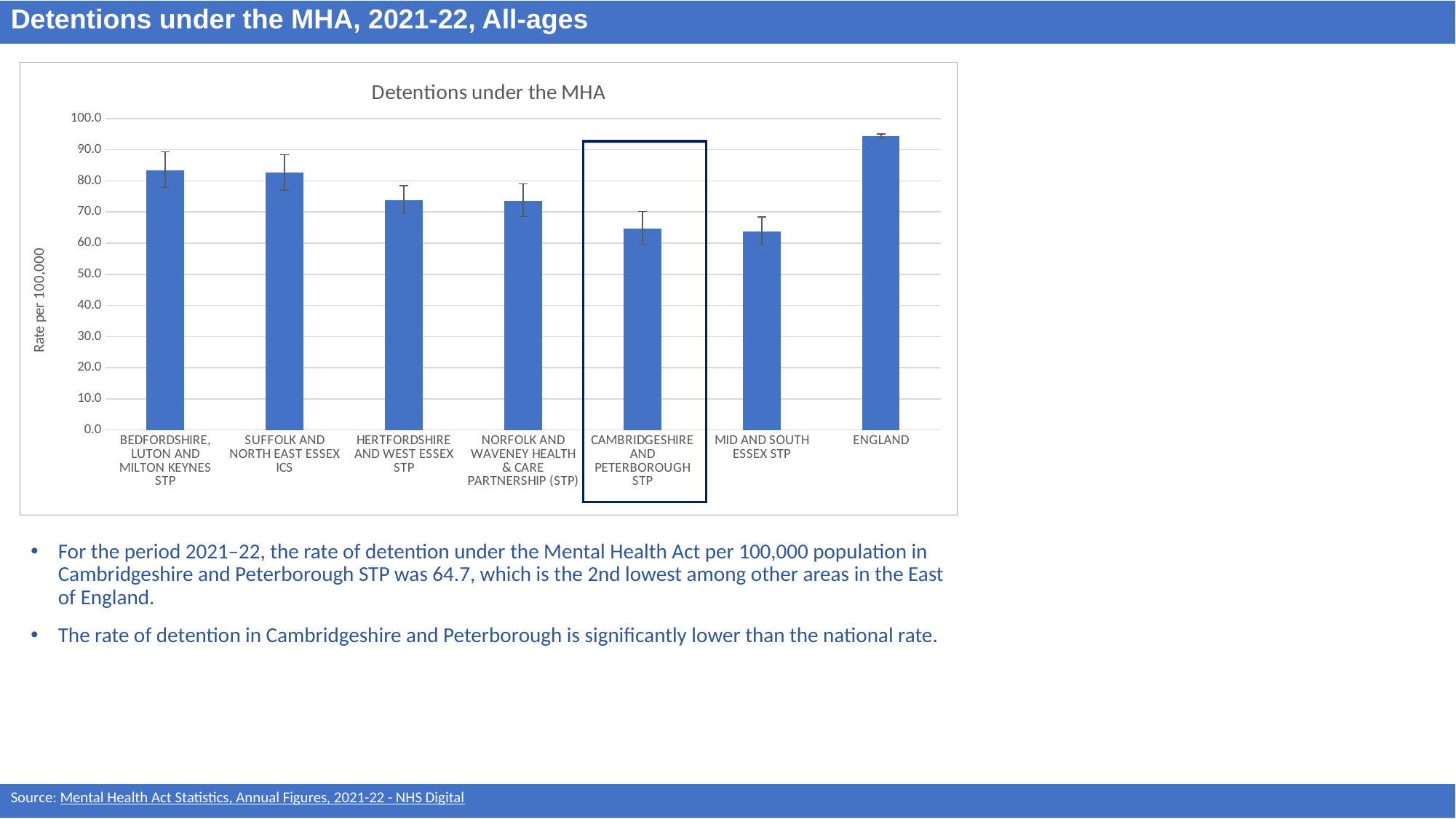
Is the value for BEDFORDSHIRE, LUTON AND MILTON KEYNES STP greater or less than 80.0? greater Which has the larger value, ENGLAND or CAMBRIDGESHIRE AND PETERBOROUGH STP? ENGLAND How many categories are plotted on the x axis of the chart? 7 Is the value for CAMBRIDGESHIRE AND PETERBOROUGH STP greater or less than 70.0? less Which has the larger value, BEDFORDSHIRE, LUTON AND MILTON KEYNES STP or HERTFORDSHIRE AND WEST ESSEX STP? BEDFORDSHIRE, LUTON AND MILTON KEYNES STP Is the value for ENGLAND greater or less than 90.0? greater What is the label on the y axis of the chart? Rate per 100,000 Which category has the highest detention rate in the chart? ENGLAND What kind of chart is shown on the slide? bar chart